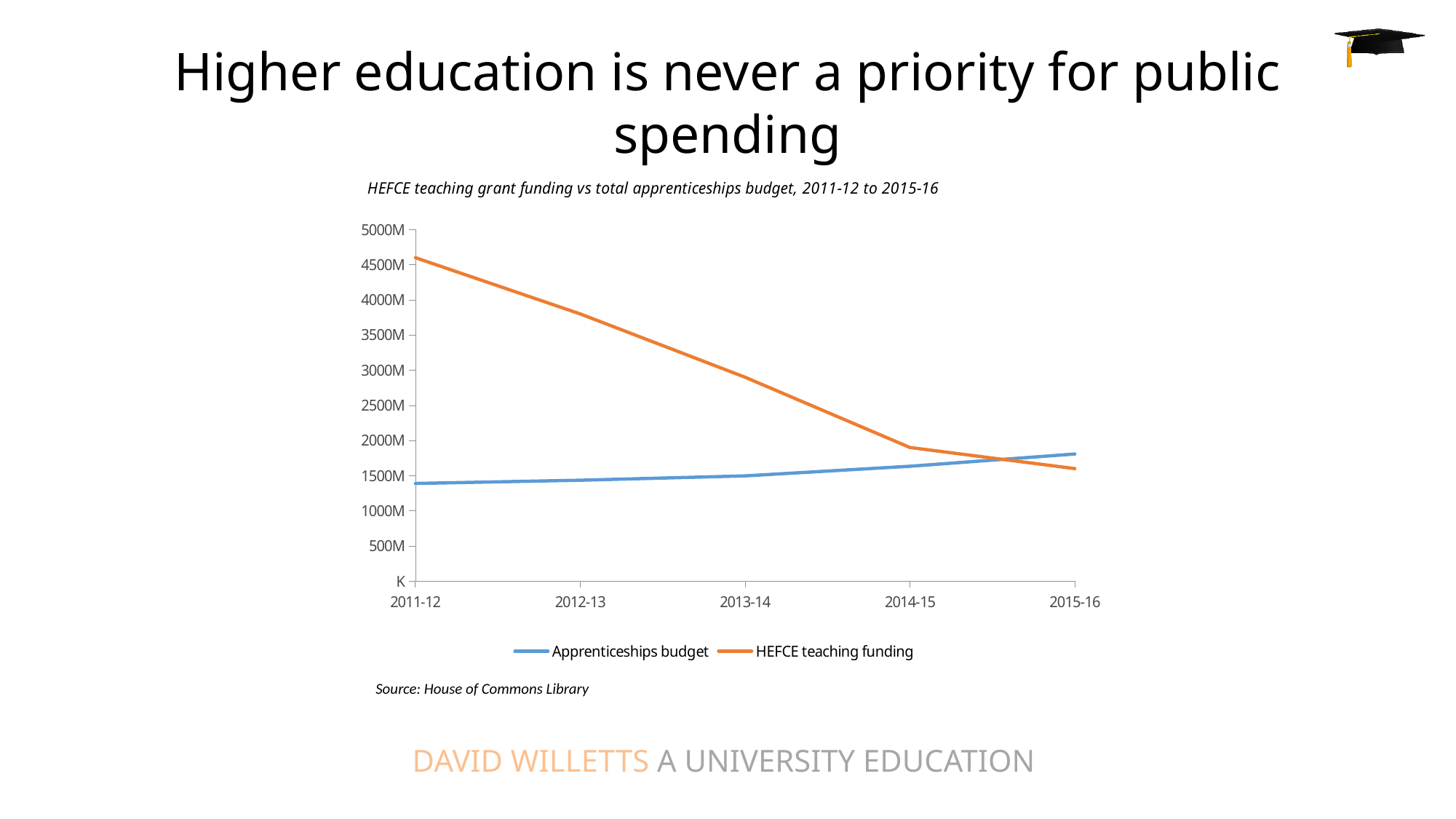
How many series does the legend list? 2 In which year is HEFCE teaching funding lowest? 2015-16 Is the value for HEFCE teaching funding in 2011-12 greater or less than 4000M? greater In 2011-12, which is larger: HEFCE teaching funding or the Apprenticeships budget? HEFCE teaching funding In which year is the Apprenticeships budget highest? 2015-16 Is the value for HEFCE teaching funding in 2014-15 greater or less than 2500M? less What kind of chart is shown on the slide? line chart Does the Apprenticeships budget rise or fall from 2011-12 to 2015-16? rise How many years are plotted along the x axis? 5 In 2015-16, which is larger: HEFCE teaching funding or the Apprenticeships budget? Apprenticeships budget In which year is HEFCE teaching funding highest? 2011-12 Does HEFCE teaching funding rise or fall from 2011-12 to 2015-16? fall